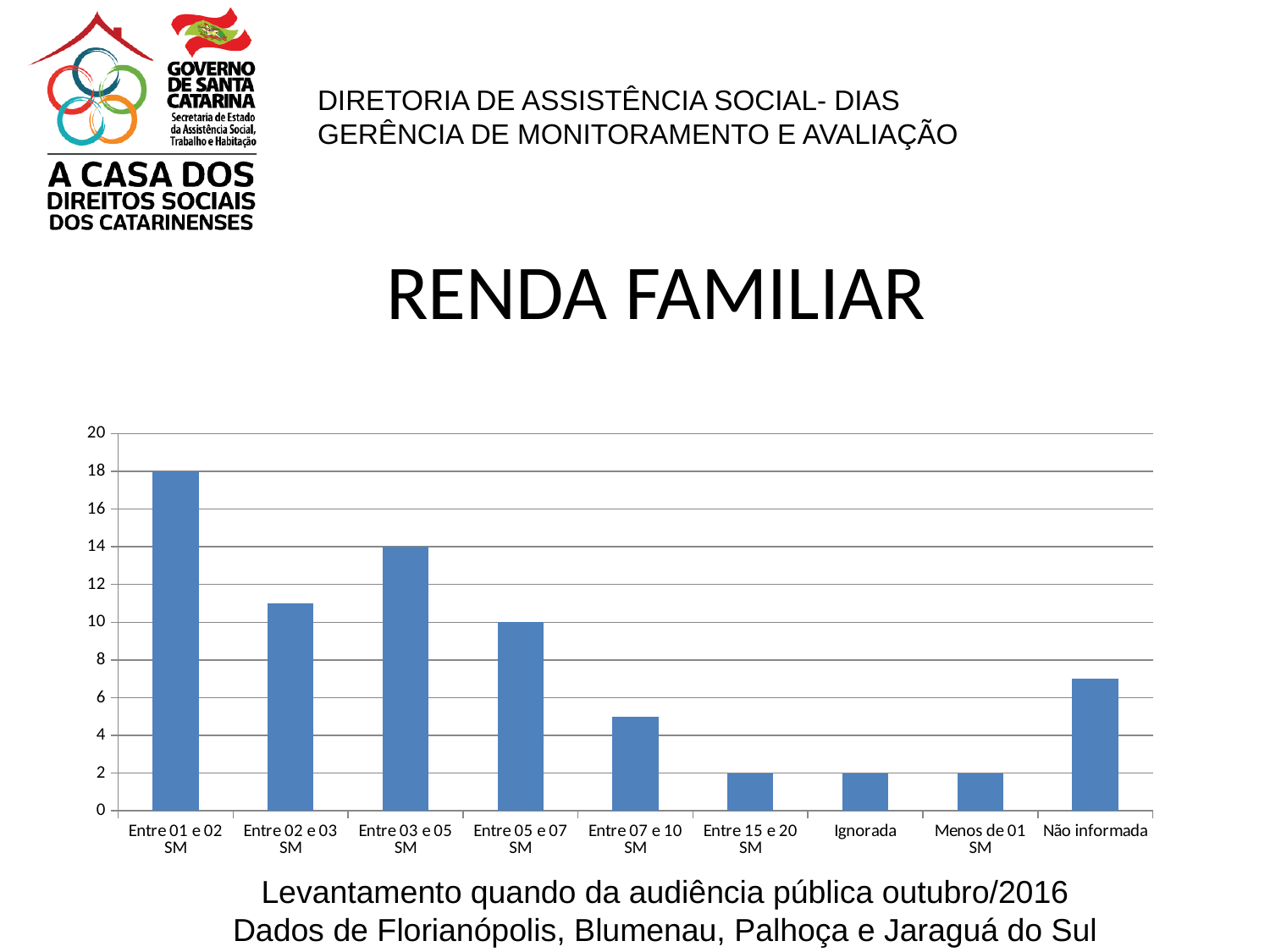
Which category has the highest value? Entre 01 e 02 SM What is the value for Entre 03 e 05 SM? 14 What kind of chart is shown on the slide? bar chart What is the value for Entre 05 e 07 SM? 10 How many categories are shown on the x axis? 9 What is the value for Ignorada? 2 What is the value for Entre 01 e 02 SM? 18 What is the difference between the values for Entre 05 e 07 SM and Menos de 01 SM? 8 Which is larger, the value for Entre 02 e 03 SM or the value for Entre 03 e 05 SM? Entre 03 e 05 SM Is the value for Não informada greater or less than 8? less Is the value for Entre 02 e 03 SM greater or less than 10? greater What is the difference between the values for Entre 01 e 02 SM and Entre 03 e 05 SM? 4